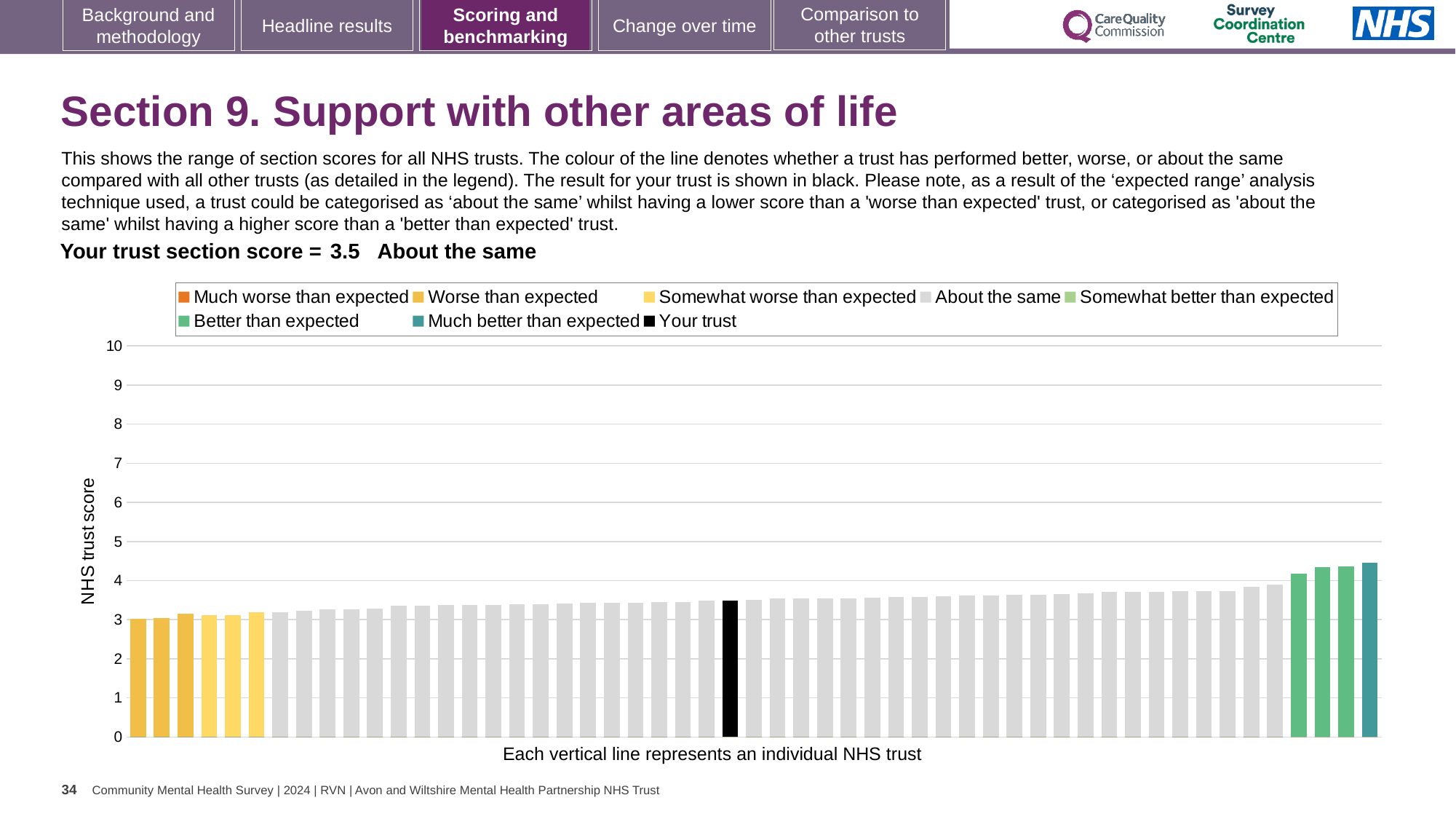
Is the highest trust score on the chart greater or less than 5? less What colour is used for the bar representing your trust? black What is the section score for your trust shown on the chart? 3.5 How many trusts are shown in the 'Much better than expected' colour? 1 Which performance category is your trust placed in for this section? About the same How many entries does the chart legend list? 8 Is the lowest trust score on the chart greater or less than 2? greater Do the trust scores rise or fall from left to right along the x axis? rise What is the label on the vertical axis of the chart? NHS trust score How many trusts are shown in the 'Better than expected' colour? 3 Is the score for your trust (the black bar) greater or less than 3? greater What kind of chart is used to show the NHS trust section scores? bar chart